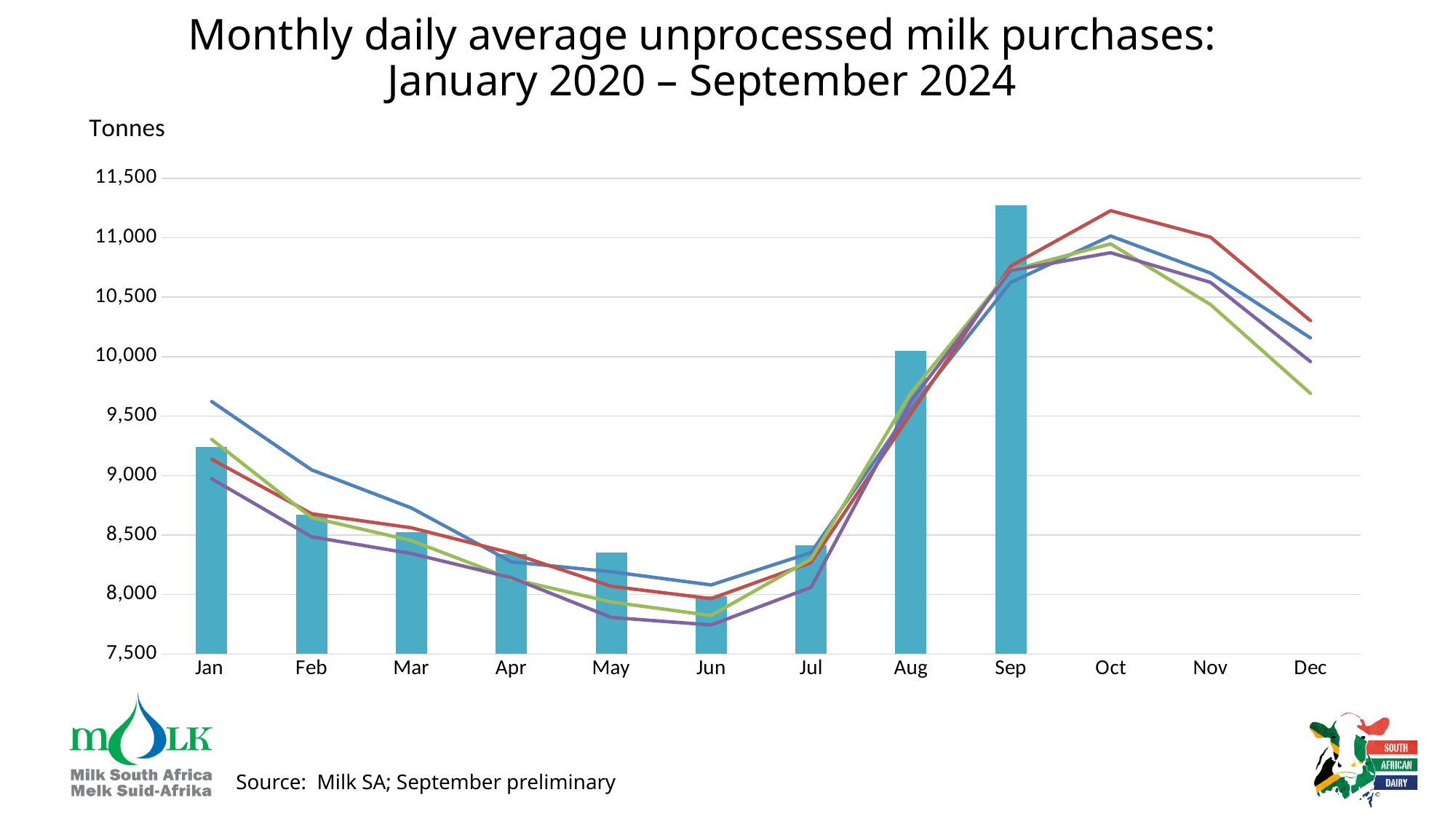
What unit is shown on the vertical axis of the chart? Tonnes Which month has the tallest bar? Sep Is the value of the Jan bar greater or less than 9,000? greater Which month has the shortest bar? Jun How many months are labelled along the x axis? 12 Which bar is taller, Jan or Feb? Jan Is the value of the Jun bar greater or less than 8,500? less How many months have a bar plotted? 9 What kind of chart is shown on the slide? A combined bar and line chart Is the value of the Sep bar greater or less than 11,000? greater Do the bars rise or fall from Jun to Sep? rise What is the title of the chart? Monthly daily average unprocessed milk purchases: January 2020 – September 2024